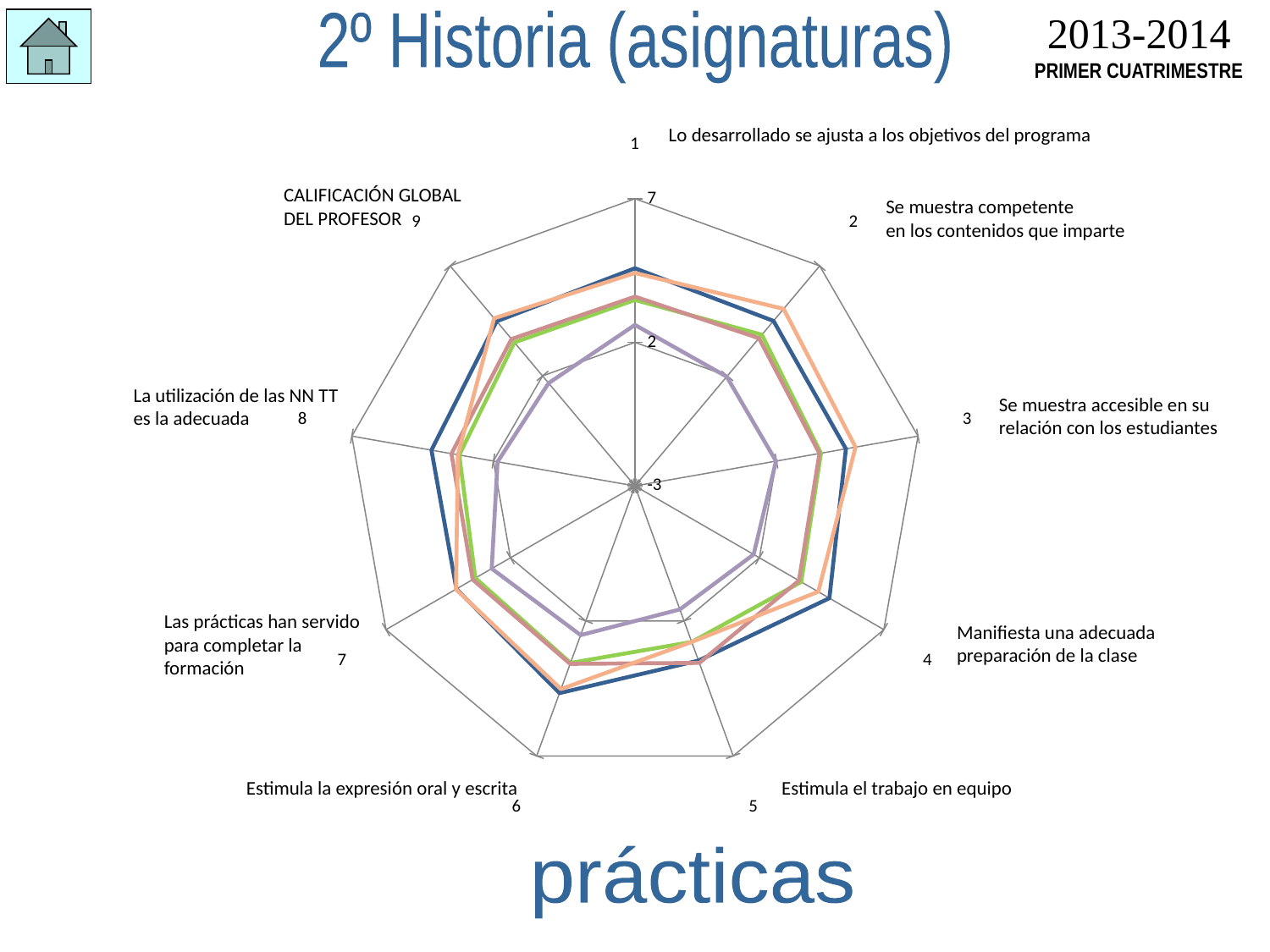
What value is marked at the outermost ring of the radar chart? 7 What is the title printed below the radar chart? prácticas Which coloured line lies closest to the centre of the radar chart across the categories? purple Which category label is numbered 1 on the radar chart? Lo desarrollado se ajusta a los objetivos del programa Which category label is numbered 5 on the radar chart? Estimula el trabajo en equipo Is the value of the dark blue line for category 6 (Estimula la expresión oral y escrita) greater or less than 2? greater What value is marked at the centre of the radar chart? -3 Is the value of the dark blue line for category 4 (Manifiesta una adecuada preparación de la clase) greater or less than 7? less Which category label is numbered 9 on the radar chart? CALIFICACIÓN GLOBAL DEL PROFESOR How many categories (axes) does the radar chart have? 9 What kind of chart is shown on the slide? radar chart Is the value of the dark blue line for category 1 (Lo desarrollado se ajusta a los objetivos del programa) greater or less than 2? greater